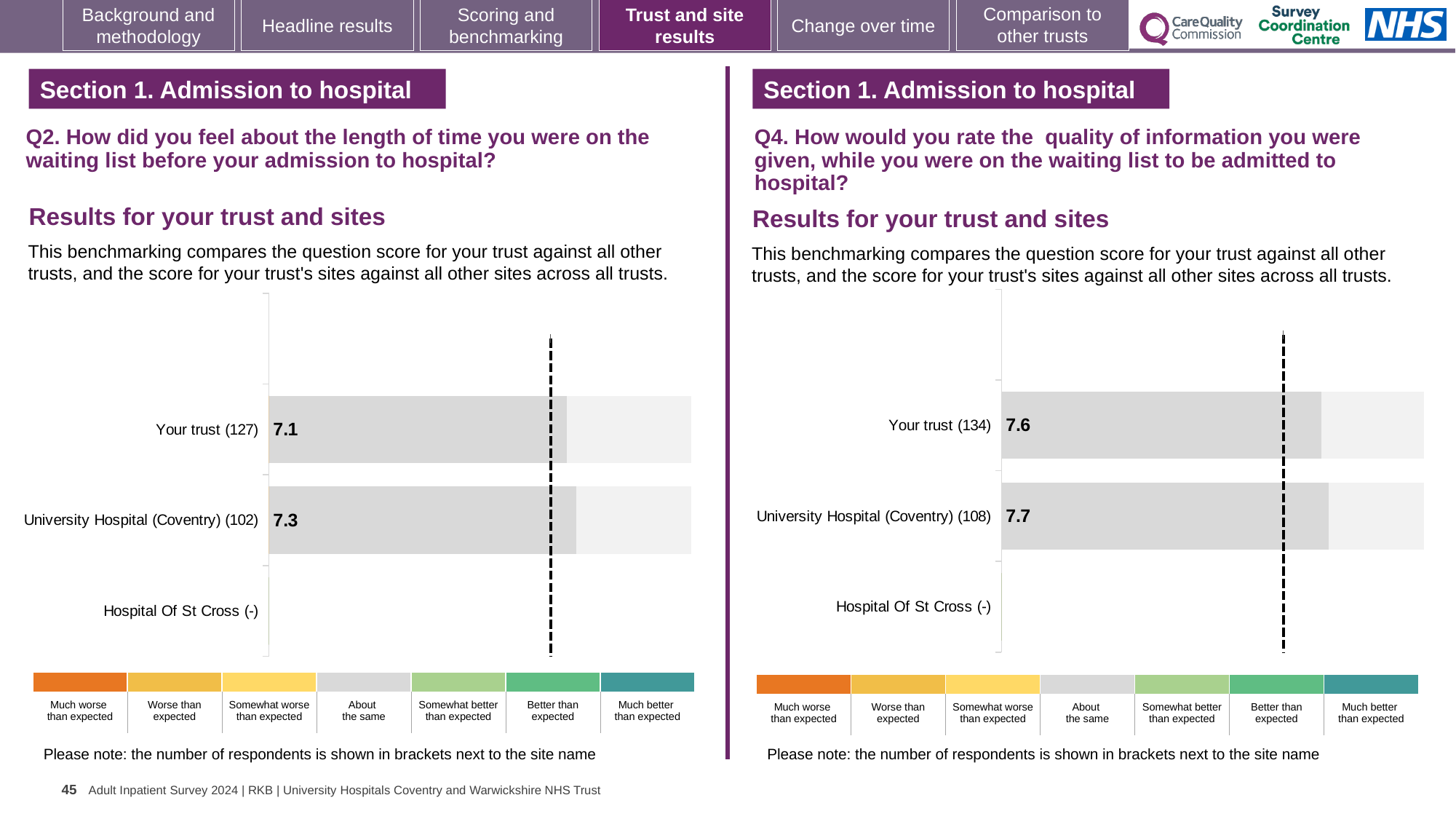
On the right chart (Q4), how many respondents are shown in brackets for University Hospital (Coventry)? 108 On the left chart (Q2), what is the difference between the University Hospital (Coventry) score and the Your trust score? 0.2 On the right chart (Q4), what is the difference between the University Hospital (Coventry) score and the Your trust score? 0.1 On the right chart (Q4), what is the score for Your trust? 7.6 On the left chart (Q2), how many respondents are shown in brackets for Your trust? 127 What kind of chart is the right chart (Q4)? Bar chart On the left chart (Q2), what is the score for Your trust? 7.1 On the right chart (Q4), which has the higher score, Your trust or University Hospital (Coventry)? University Hospital (Coventry) How many categories are listed on the left chart (Q2)? 3 On the left chart (Q2), which has the higher score, Your trust or University Hospital (Coventry)? University Hospital (Coventry) On the right chart (Q4), what is the score for University Hospital (Coventry)? 7.7 On the left chart (Q2), what is the score for University Hospital (Coventry)? 7.3